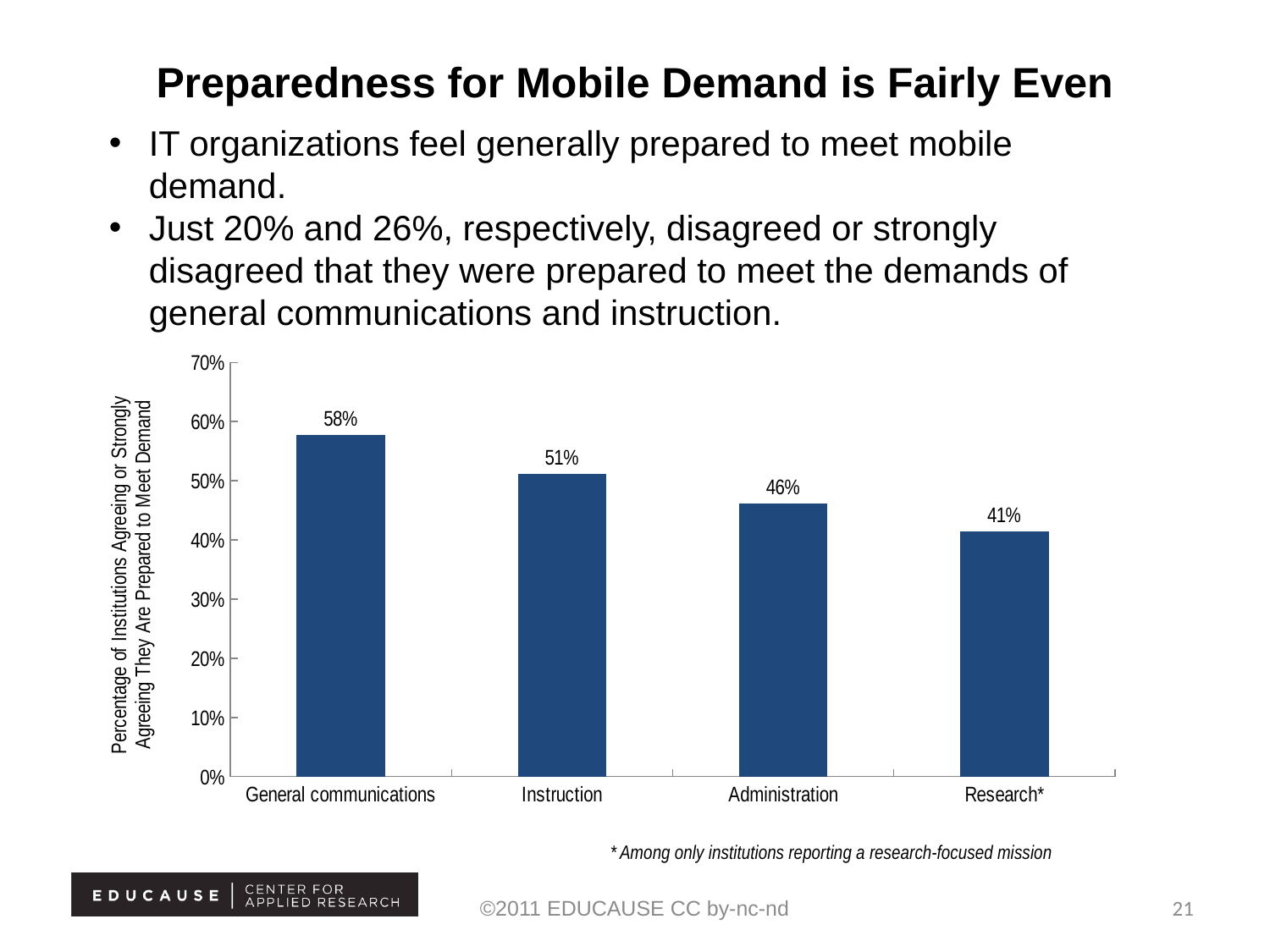
Which is larger, the value for Instruction or the value for Administration? Instruction What is the difference in percentage points between General communications and Research*? 17 percentage points What kind of chart is shown on the slide? Bar chart What percentage of institutions agree or strongly agree they are prepared to meet mobile demand for General communications? 58% Do the values rise or fall moving from left to right along the x axis? Fall Which category has the highest percentage of institutions agreeing they are prepared? General communications What is the value shown for Research*? 41% Is the value for Administration greater or less than 50%? less What is the value shown for Instruction? 51% How many categories are shown on the x axis of the chart? 4 Which category has the lowest percentage of institutions agreeing they are prepared? Research* What is the value shown for Administration? 46%